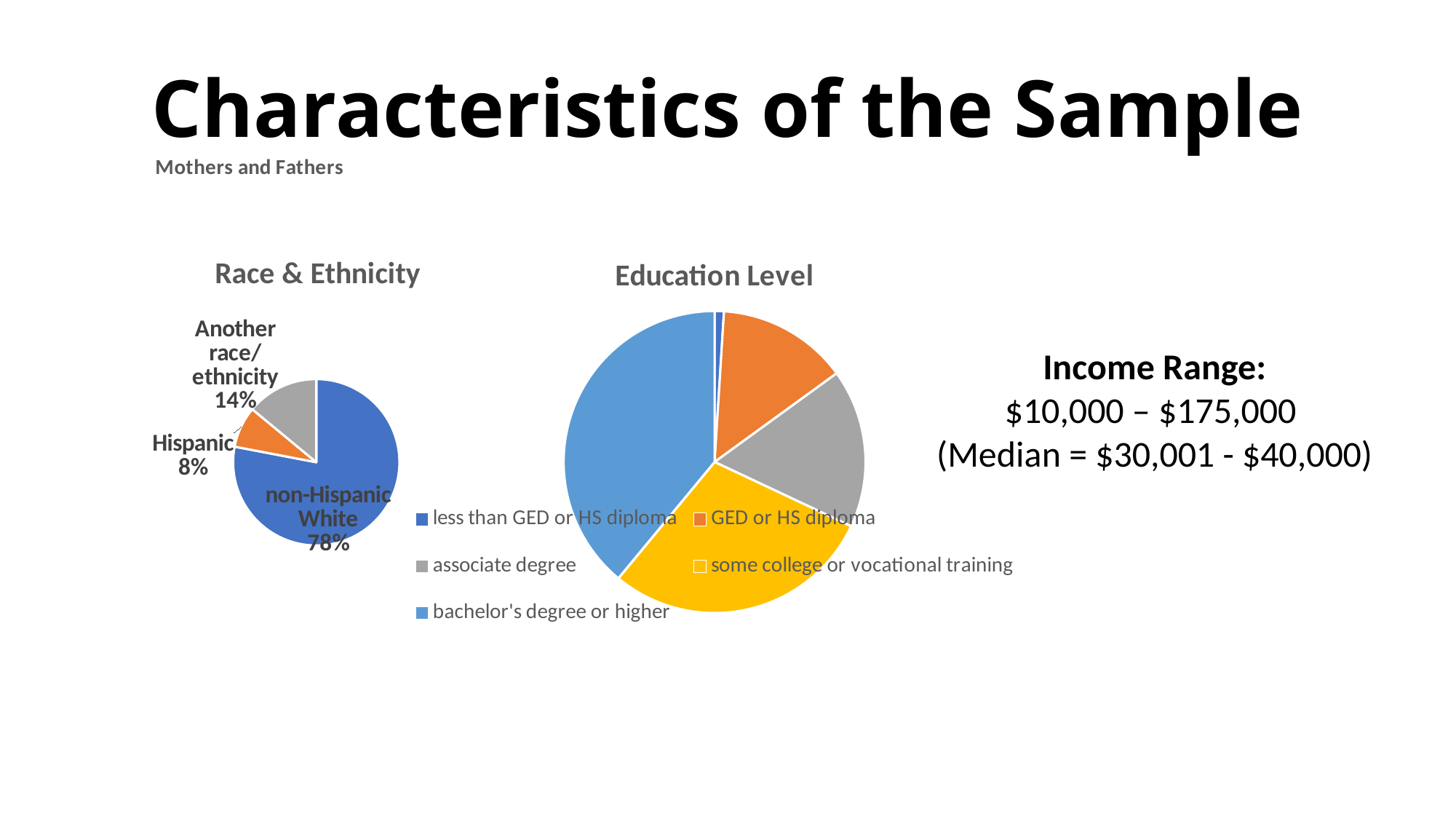
In the Race & Ethnicity pie chart, what percentage is labelled 'Another race/ethnicity'? 14% In the Race & Ethnicity pie chart, which category has the largest slice? non-Hispanic White In the Race & Ethnicity pie chart, what percentage of the sample is non-Hispanic White? 78% How many categories are shown in the Race & Ethnicity pie chart? 3 In the Education Level pie chart, which category has the smallest slice? less than GED or HS diploma In the Education Level pie chart, which slice is larger: 'some college or vocational training' or 'GED or HS diploma'? some college or vocational training How many categories does the legend of the Education Level chart list? 5 What kind of chart is the Race & Ethnicity chart? Pie chart In the Race & Ethnicity pie chart, what share of the sample is Hispanic? 8% In the Education Level pie chart, which category has the largest slice? bachelor's degree or higher In the Race & Ethnicity pie chart, which category has the smallest slice? Hispanic In the Race & Ethnicity pie chart, what is the difference in percentage points between non-Hispanic White and Another race/ethnicity? 64 percentage points